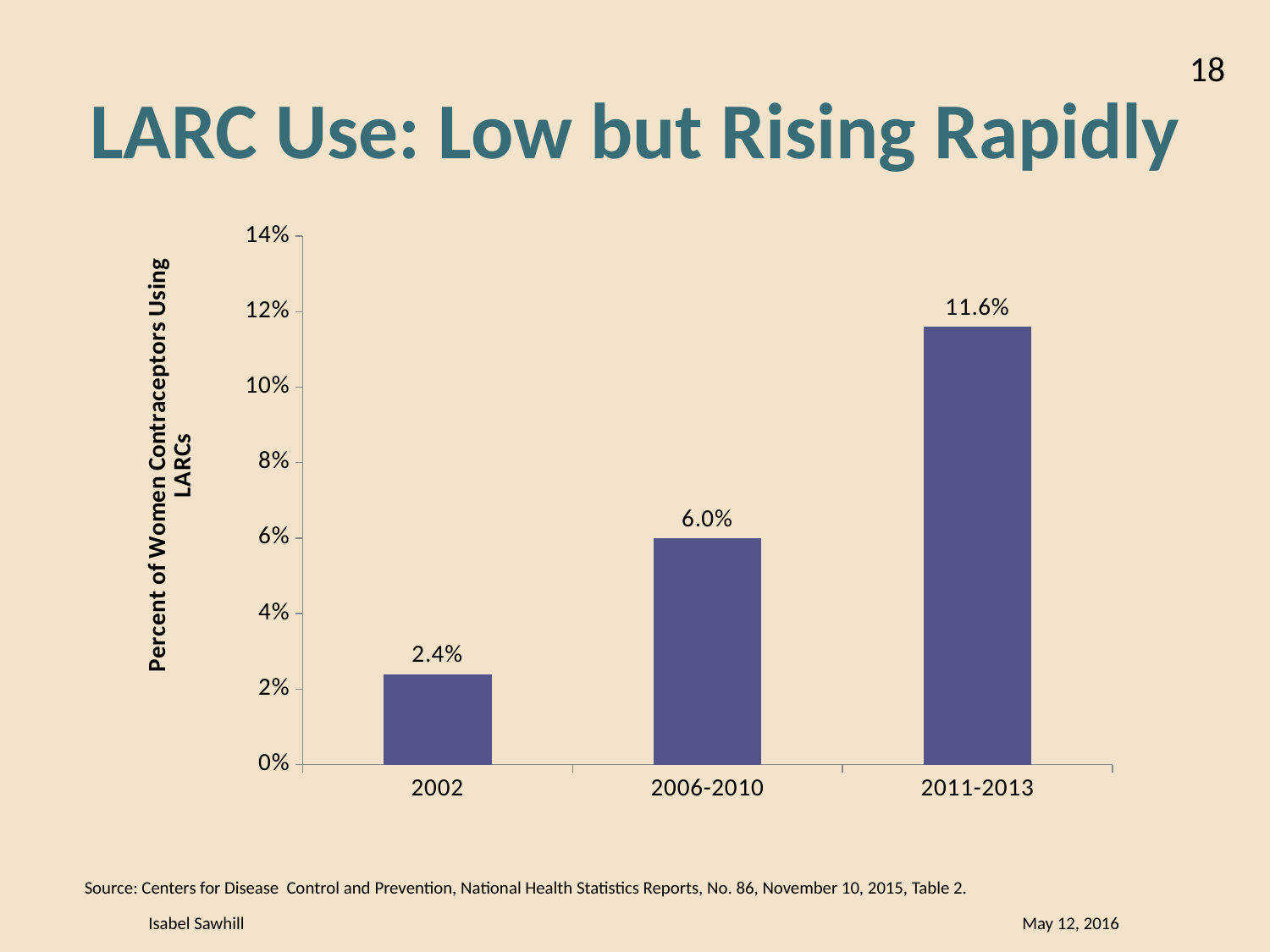
What is the difference in LARC use between 2006-2010 and 2002? 3.6% What is the difference in LARC use between 2011-2013 and 2002? 9.2% What kind of chart is shown on the slide? Bar chart How many periods are shown on the x axis of the chart? 3 Which period has a higher LARC use, 2006-2010 or 2011-2013? 2011-2013 Which period has the highest percent of women contraceptors using LARCs? 2011-2013 Is the value for 2011-2013 greater or less than 10%? greater What is the percent of women contraceptors using LARCs in 2002? 2.4% Do the values rise or fall from 2002 to 2011-2013? Rise Which period has the lowest percent of women contraceptors using LARCs? 2002 What is the percent of women contraceptors using LARCs in 2006-2010? 6.0% What is the percent of women contraceptors using LARCs in 2011-2013? 11.6%